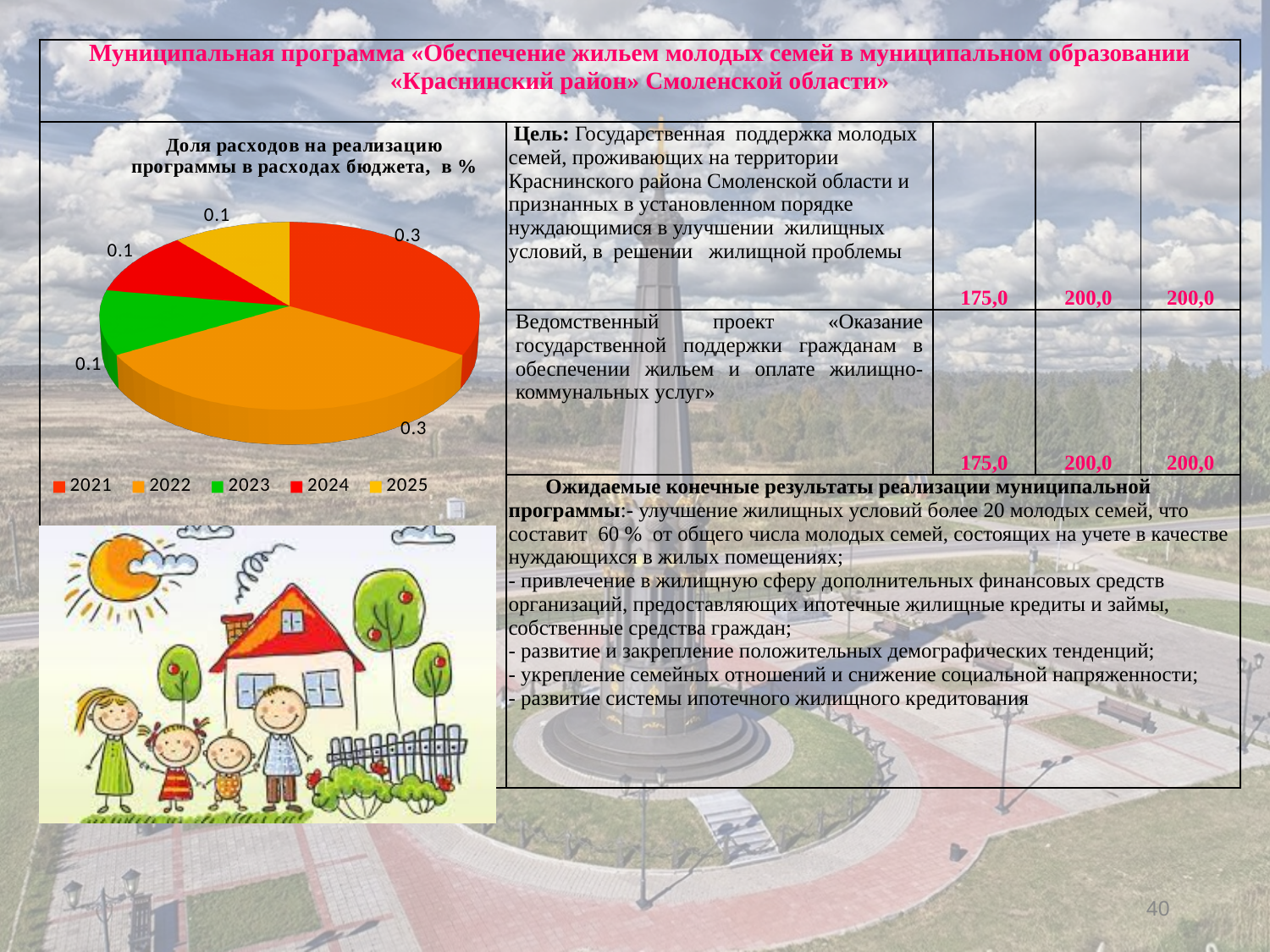
What is the value shown for 2025 in the pie chart? 0.1 What is the title of the pie chart on the slide? Доля расходов на реализацию программы в расходах бюджета, в % How many slices does the pie chart have? 5 What is the value shown for 2021 in the pie chart? 0.3 In the pie chart, which is larger, the value for 2022 or the value for 2024? 2022 What kind of chart is shown on the left of the slide? pie chart What is the value shown for 2023 in the pie chart? 0.1 How many entries does the legend of the pie chart list? 5 What colour is the slice for 2023 in the pie chart? green What is the value shown for 2022 in the pie chart? 0.3 Which years in the pie chart legend are shown with the value 0.1? 2023, 2024, 2025 In the pie chart, what is the difference between the value for 2021 and the value for 2023? 0.2